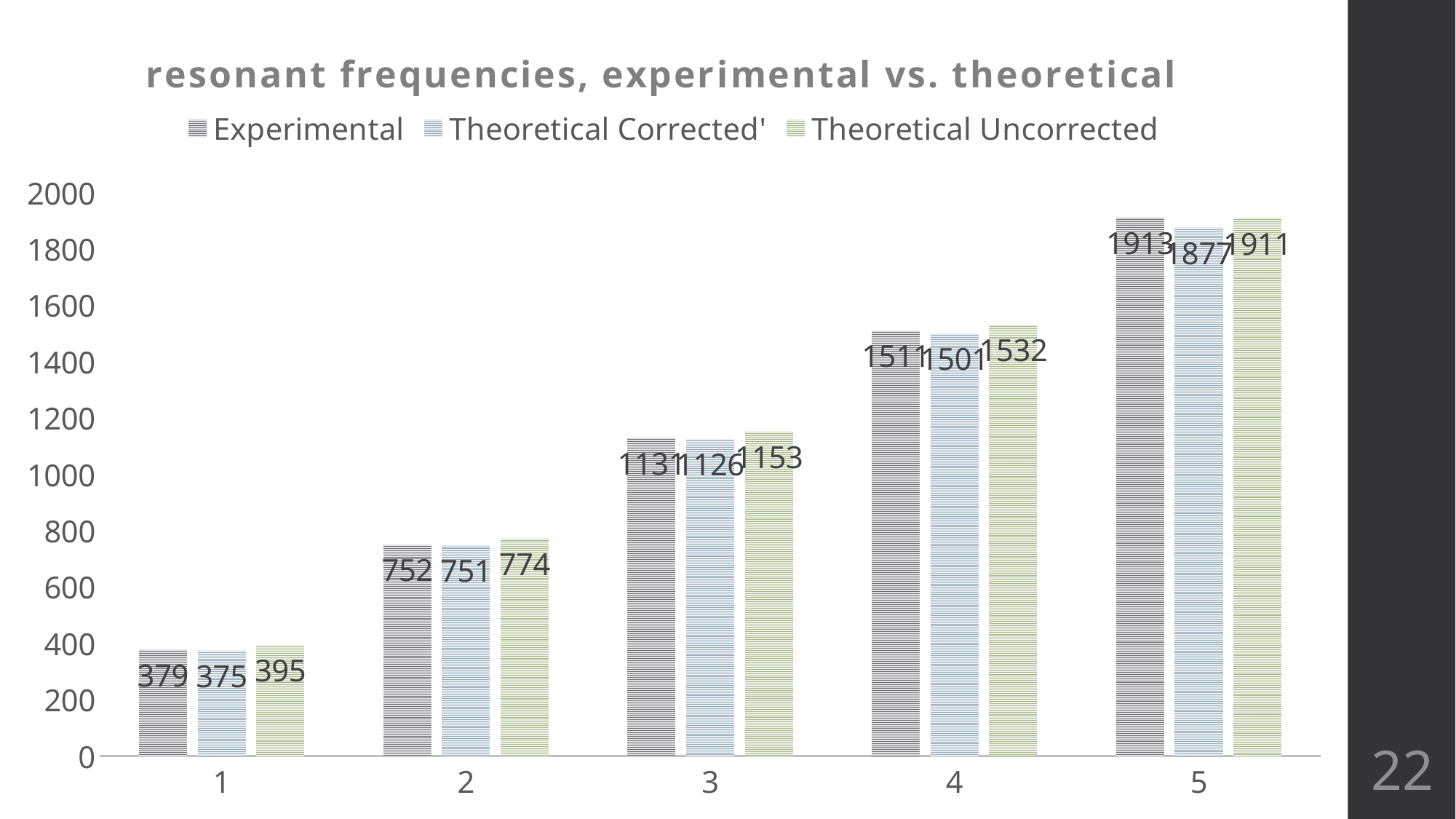
What is the title of the chart? resonant frequencies, experimental vs. theoretical What is the Theoretical Uncorrected value for category 2? 774 How many categories are shown on the x axis? 5 Which category has the highest Experimental value? 5 What is the Theoretical Corrected' value for category 5? 1877 What is the Theoretical Uncorrected value for category 4? 1532 Which category has the lowest Theoretical Uncorrected value? 1 What is the difference between the Theoretical Uncorrected and Experimental values for category 1? 16 What type of chart is shown on the slide? bar chart Do the Experimental values rise or fall from category 1 to category 5? rise How many series does the legend list? 3 What is the Experimental value for category 1? 379